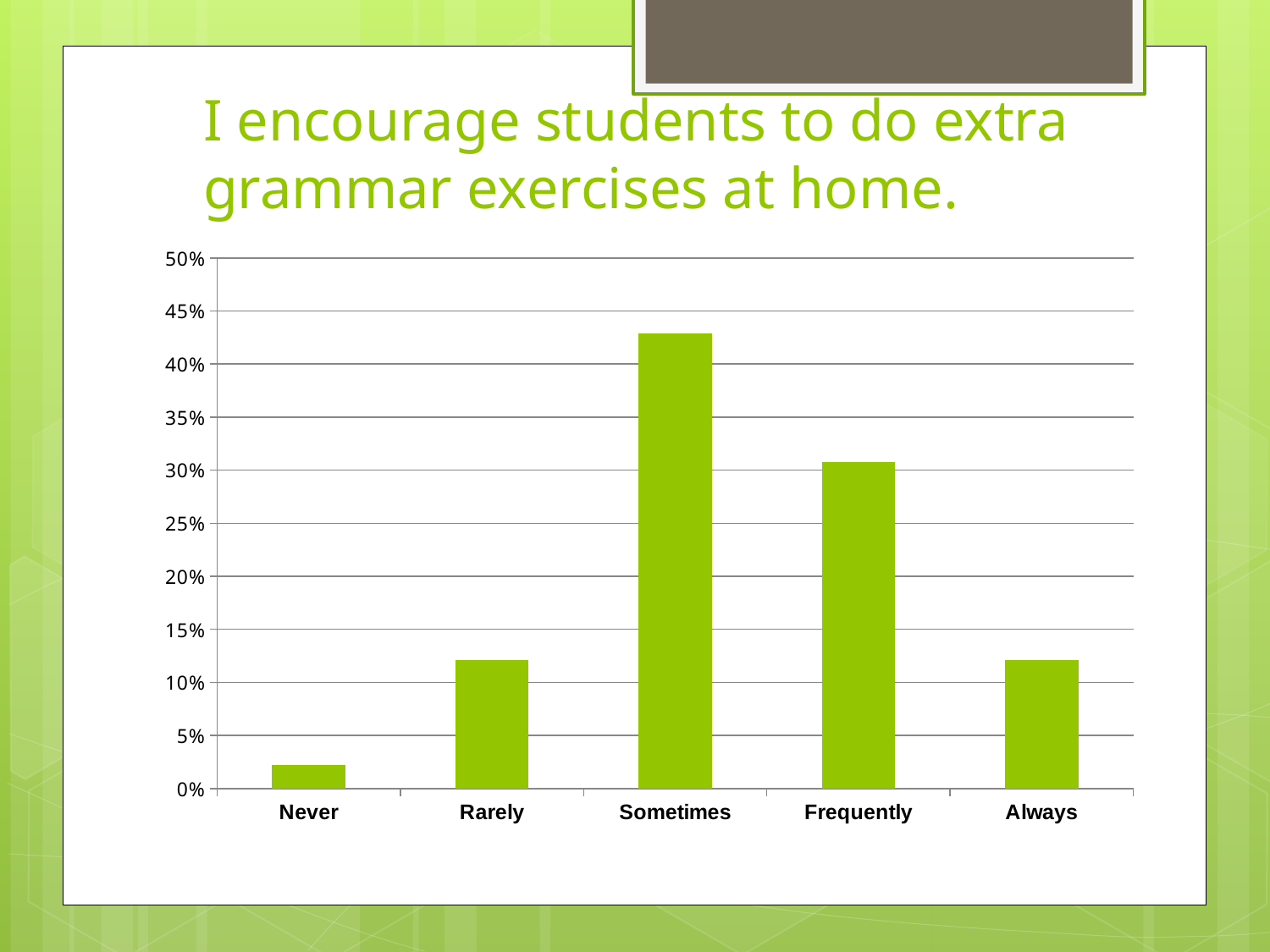
What kind of chart is shown on the slide? bar chart What is the title of the chart on the slide? I encourage students to do extra grammar exercises at home. Which category has the lowest value in the chart? Never Is the value for Frequently greater or less than 25%? greater Is the value for Always greater or less than 15%? less How many categories are shown on the x axis of the chart? 5 Is the value for Never greater or less than 5%? less Which is larger, the value for Rarely or the value for Never? Rarely Which category has the highest value in the chart? Sometimes Which is larger, the value for Sometimes or the value for Frequently? Sometimes